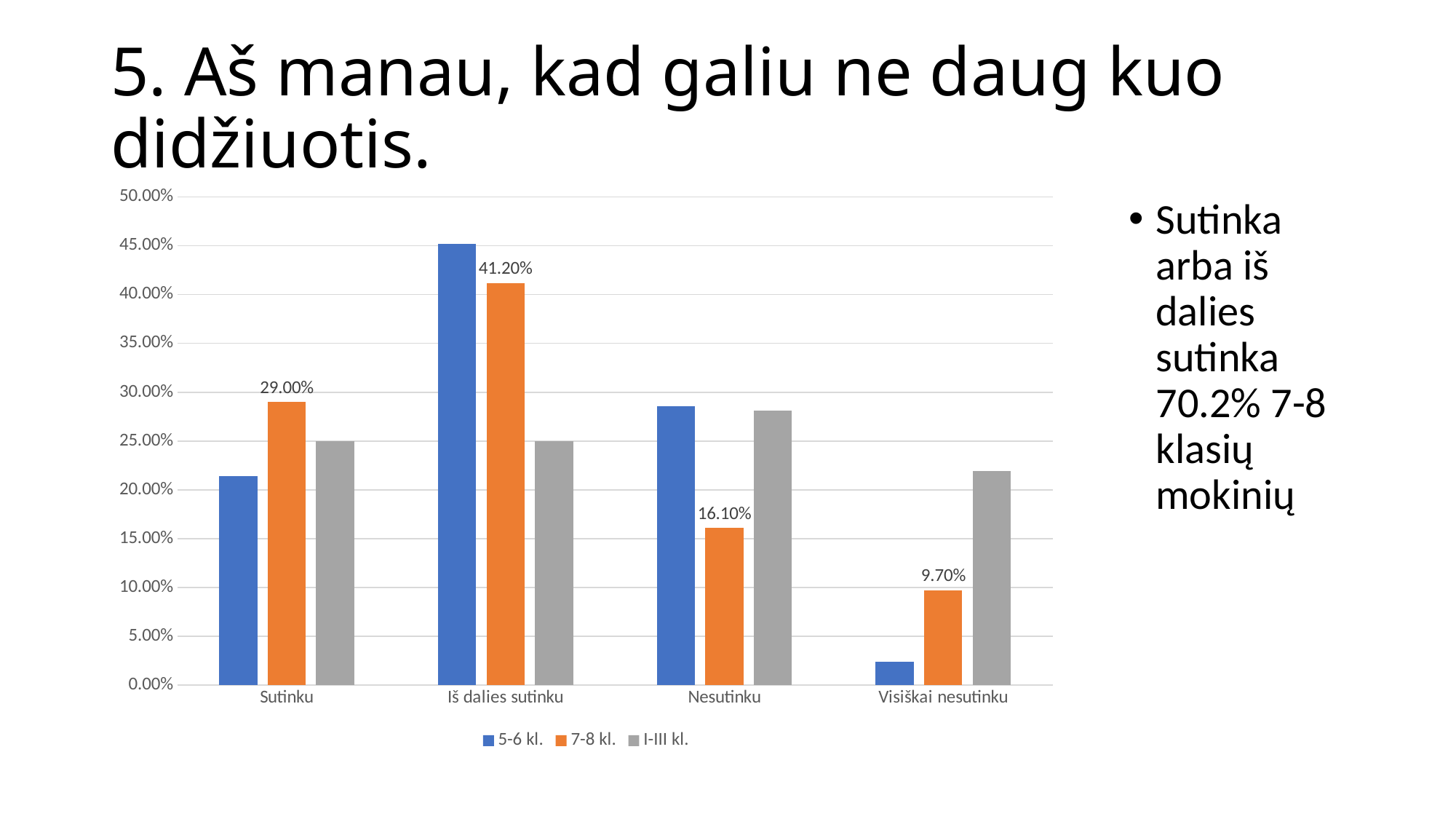
What is the difference between the 7-8 kl. values for Iš dalies sutinku and Nesutinku? 25.10% How many series does the legend list? 3 How many categories are shown on the x axis? 4 In the Iš dalies sutinku category, which series has the larger value, 5-6 kl. or 7-8 kl.? 5-6 kl. What is the value for 7-8 kl. in the Sutinku category? 29.00% Is the value for 5-6 kl. in the Visiškai nesutinku category greater or less than 5.00%? less What is the value for 7-8 kl. in the Iš dalies sutinku category? 41.20% What kind of chart is shown on the slide? bar chart For the 7-8 kl. series, which category has the highest value? Iš dalies sutinku What is the difference between the 7-8 kl. values for Sutinku and Visiškai nesutinku? 19.30% For the 7-8 kl. series, which category has the lowest value? Visiškai nesutinku What is the value for 7-8 kl. in the Visiškai nesutinku category? 9.70%